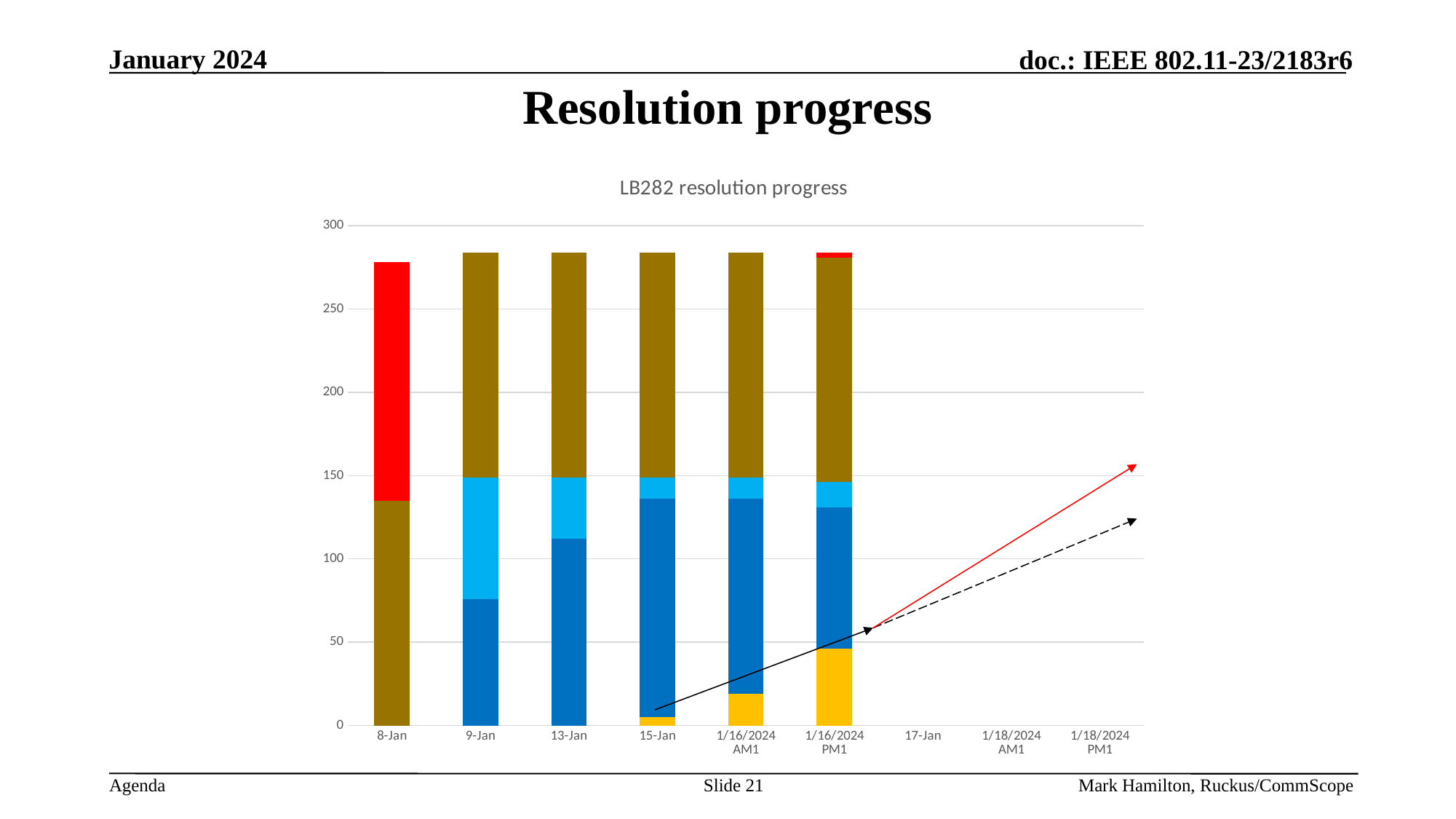
How many category labels are shown along the x axis of the chart? 9 Is the total height of the 8-Jan bar greater or less than 250? greater What is the highest value shown on the y axis of the chart? 300 What is the title of the chart? LB282 resolution progress Does the yellow segment at the bottom of the bars rise or fall from 15-Jan to 1/16/2024 PM1? rise Is the top of the dark blue segment in the 9-Jan bar greater or less than 100? less Is the yellow segment in the 1/16/2024 PM1 bar greater or less than 100? less How many of the x-axis categories have a bar plotted? 6 Which bar has the larger red segment, 8-Jan or 1/16/2024 PM1? 8-Jan What kind of chart is shown on the slide? Stacked bar chart